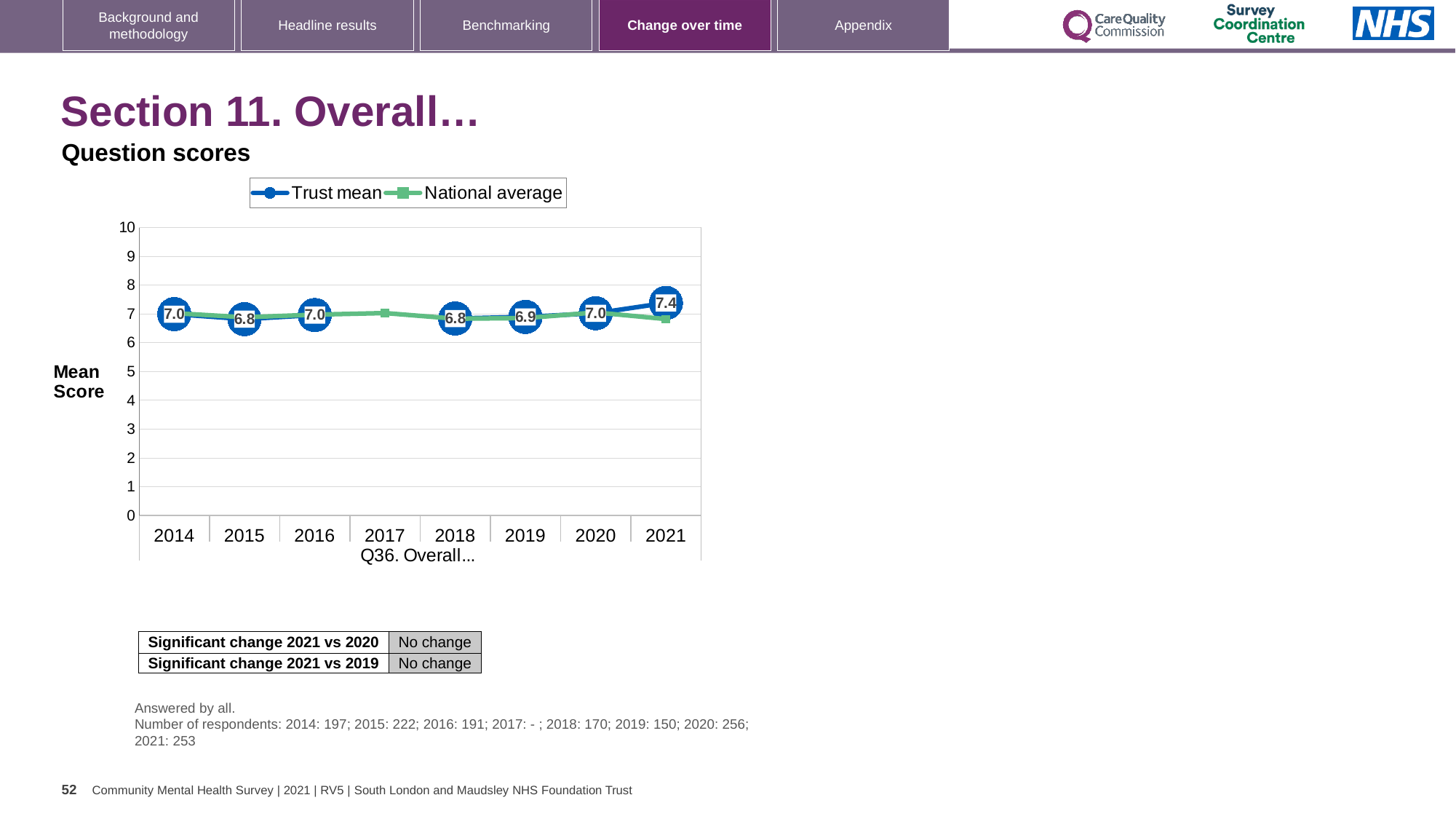
What is the Trust mean for 2015? 6.8 What is the Trust mean for 2019? 6.9 How many years are shown on the x axis? 8 Does the Trust mean rise or fall from 2019 to 2021? rise In which year is the Trust mean highest? 2021 What is the difference between the Trust mean in 2021 and in 2020? 0.4 What is the label on the y axis? Mean Score What kind of chart is shown? line chart Which is larger, the Trust mean for 2021 or for 2019? 2021 How many series does the legend list? 2 Is the National average for 2017 greater or less than 5? greater What is the Trust mean for 2021? 7.4